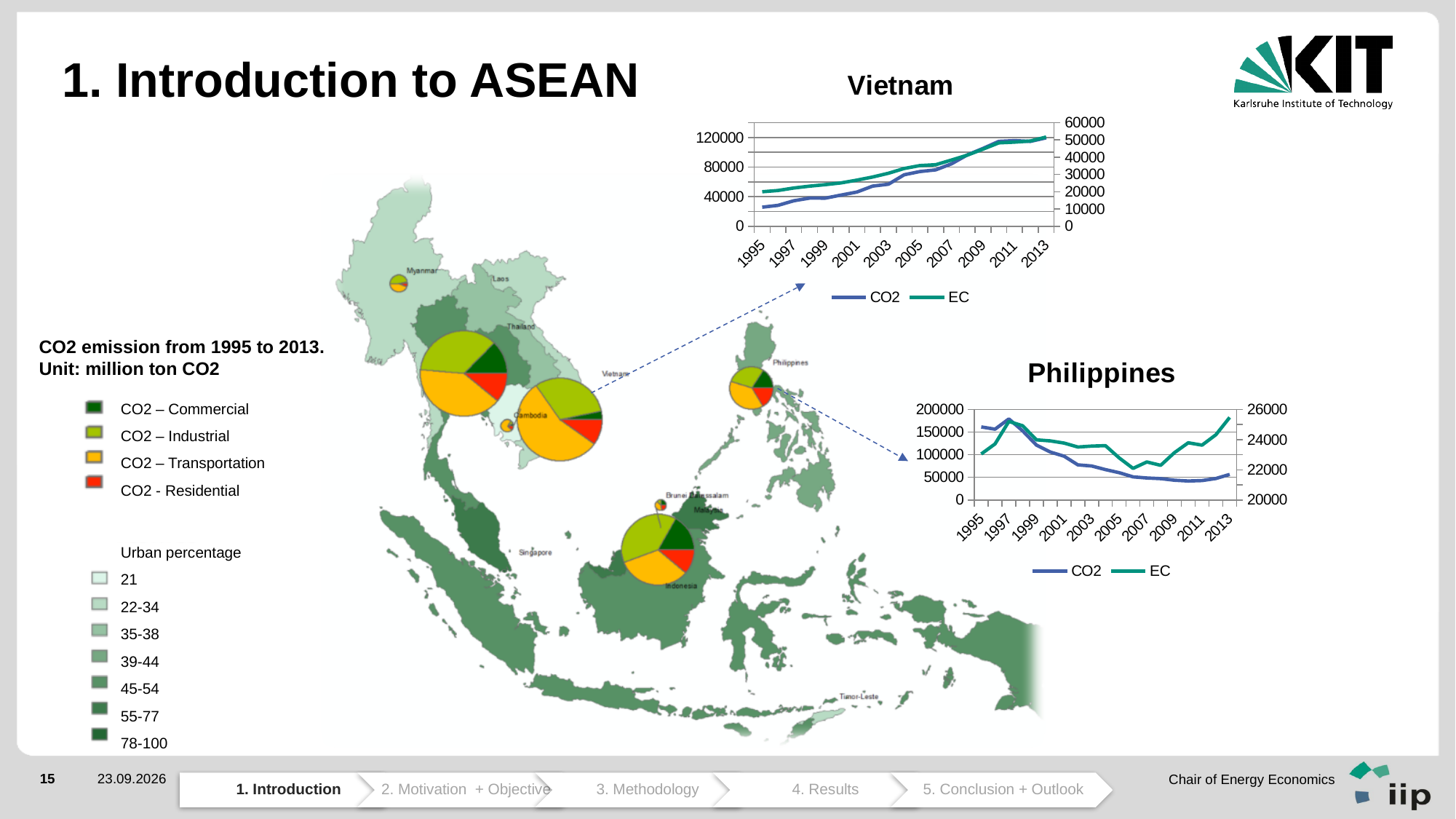
In the Philippines chart, is the CO2 value for 1995 greater or less than 100000 on the left axis? greater How many series does the legend of the Vietnam chart list? 2 What kind of chart is the Philippines chart? line chart What kind of chart is the Vietnam chart? line chart In the Philippines chart, which two series are listed in the legend? CO2 and EC In the Philippines chart, is the CO2 value for 2013 greater or less than 100000 on the left axis? less How many year labels are shown on the x axis of the Vietnam chart? 10 In the Vietnam chart, is the CO2 value for 1995 greater or less than 40000 on the left axis? less In the Vietnam chart, does the CO2 series rise or fall from 1995 to 2013? rise In the Philippines chart, does the CO2 series rise or fall overall from 1995 to 2013? fall